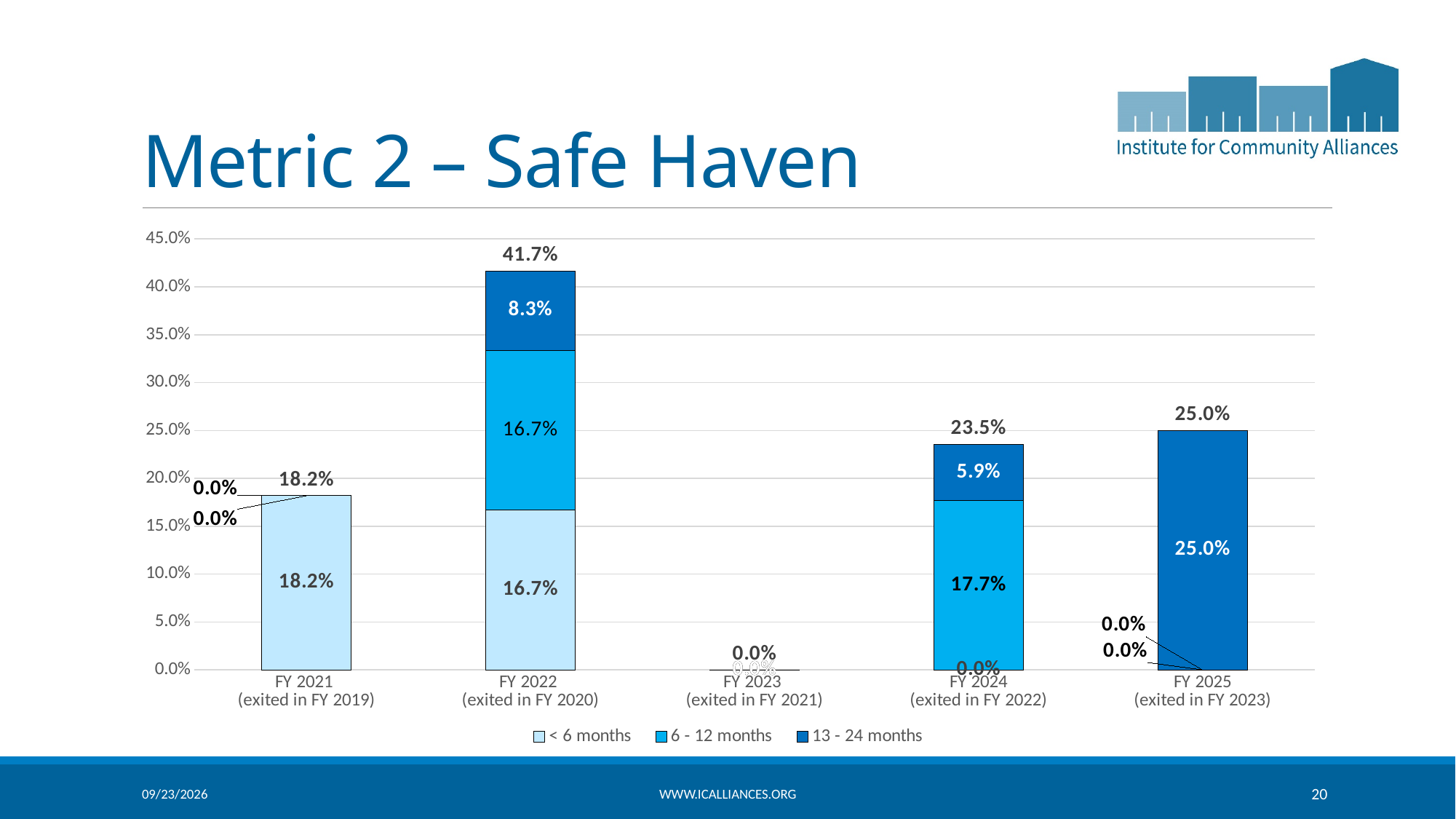
How many series does the legend list? 3 What is the value of the 13 - 24 months segment for FY 2025 (exited in FY 2023)? 25.0% Which is larger: the total for FY 2025 or the total for FY 2024? FY 2025 How many fiscal year categories are shown on the x axis? 5 What is the total value of the stacked bar for FY 2022 (exited in FY 2020)? 41.7% Which fiscal year has the highest total bar? FY 2022 (exited in FY 2020) What is the value of the 6 - 12 months segment for FY 2024 (exited in FY 2022)? 17.7% What kind of chart is shown on the slide? Stacked bar chart Which fiscal year has the lowest total bar? FY 2023 (exited in FY 2021) What is the value of the 13 - 24 months segment for FY 2022 (exited in FY 2020)? 8.3% What is the value of the < 6 months segment for FY 2021 (exited in FY 2019)? 18.2% What is the difference between the total for FY 2022 and the total for FY 2024? 18.2%